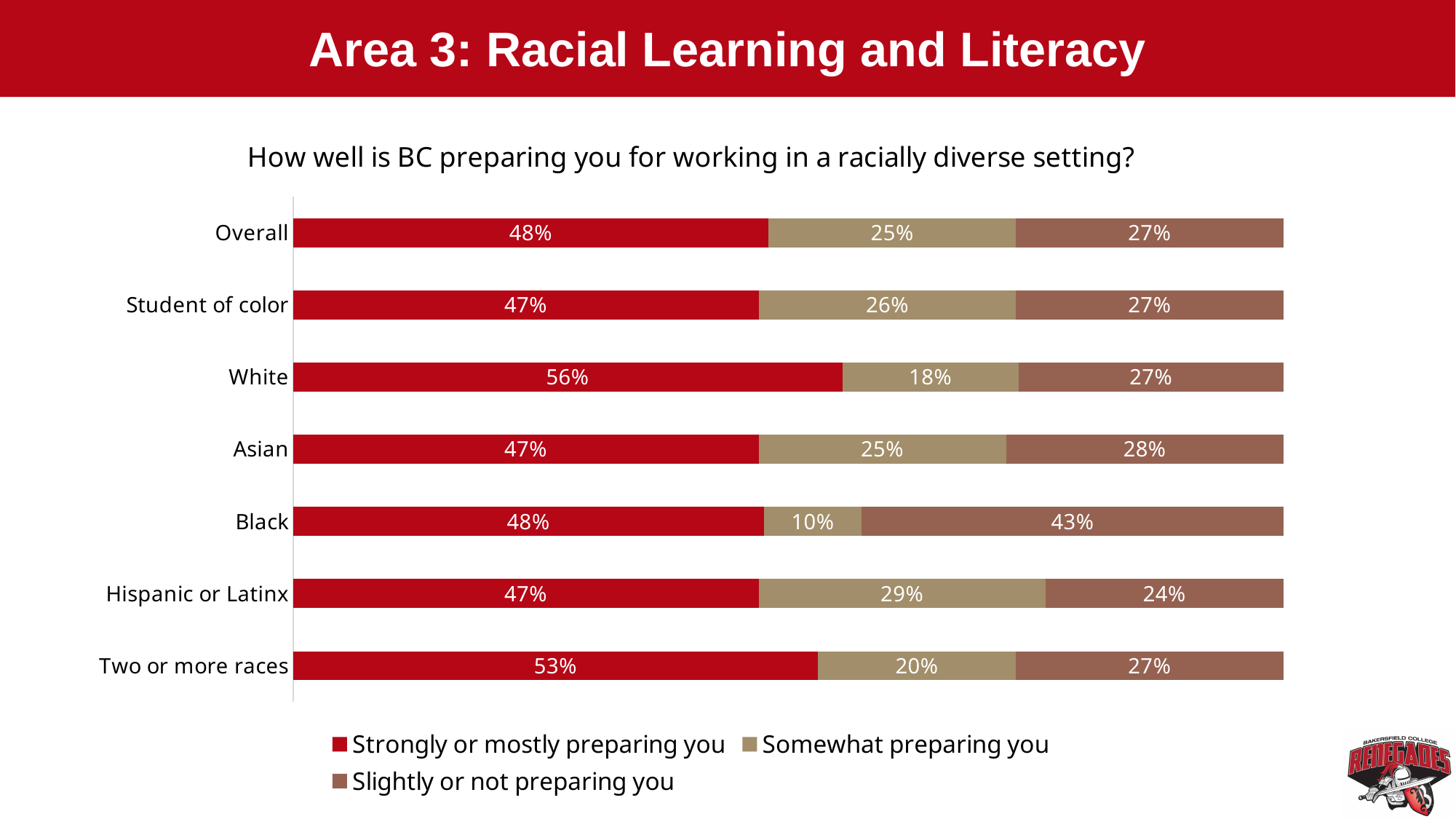
Which has a larger 'Somewhat preparing you' value: Hispanic or Latinx, or Two or more races? Hispanic or Latinx How many series does the legend list? 3 What is the difference between the 'Slightly or not preparing you' value for Black students and for Overall? 16 What percentage of Overall respondents said BC is strongly or mostly preparing them? 48% How many groups are shown on the chart? 7 What kind of chart is shown on the slide? Stacked bar chart Which group has the lowest 'Somewhat preparing you' percentage? Black What is the 'Slightly or not preparing you' value for Black students? 43% What is the 'Somewhat preparing you' value for Hispanic or Latinx students? 29% Which group has the highest 'Slightly or not preparing you' percentage? Black How many percentage points higher is the 'Strongly or mostly preparing you' value for White students than for Asian students? 9 Which group has the highest 'Strongly or mostly preparing you' percentage? White